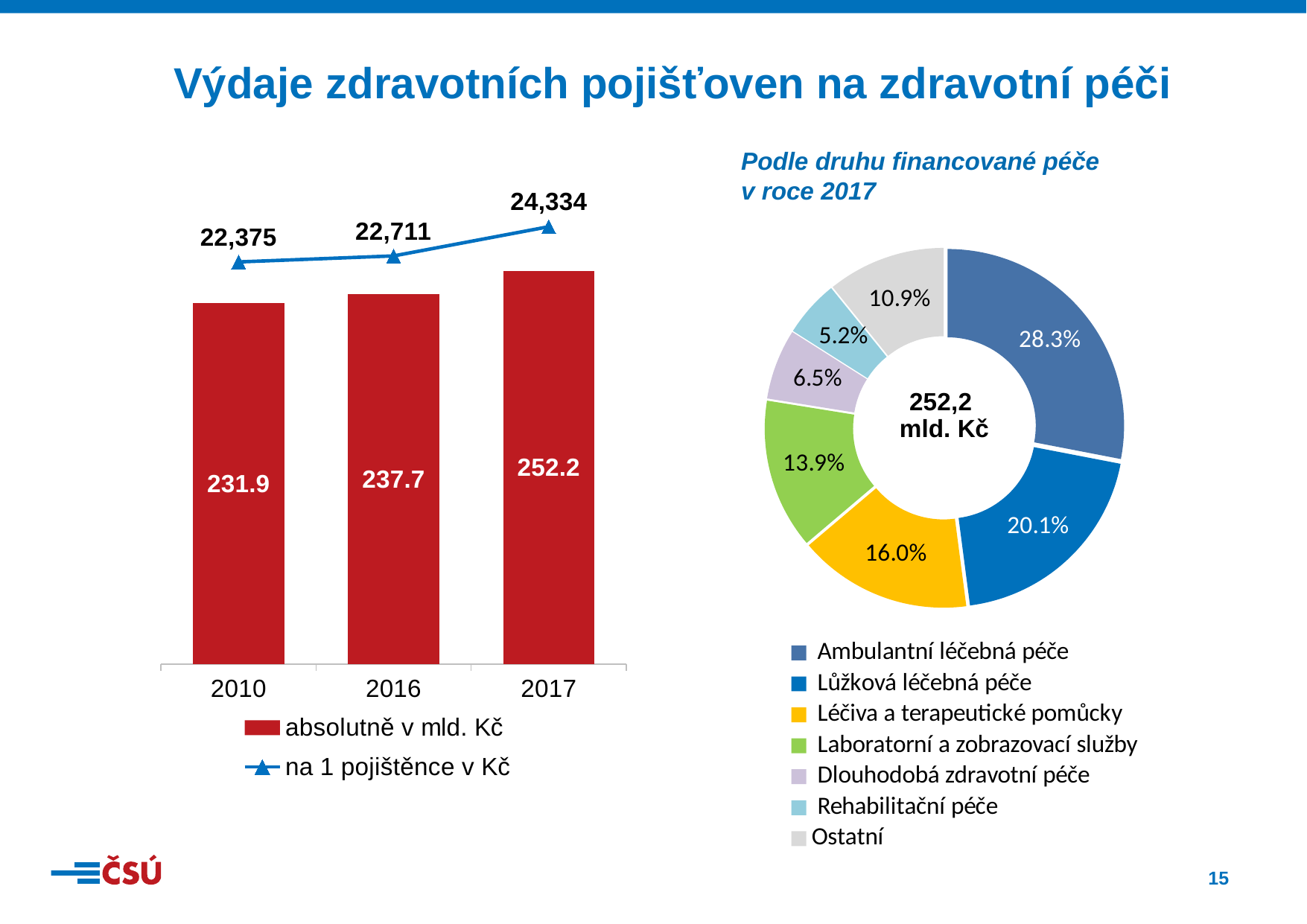
In the right chart 'Podle druhu financované péče v roce 2017', what share does 'Lůžková léčebná péče' have? 20.1% In the right chart 'Podle druhu financované péče v roce 2017', which category has the largest share? Ambulantní léčebná péče In the left chart, what is the value of 'na 1 pojištěnce v Kč' for 2016? 22,711 How many categories does the legend of the right chart 'Podle druhu financované péče v roce 2017' list? 7 In the right chart 'Podle druhu financované péče v roce 2017', which category has the smallest share? Rehabilitační péče In the left chart, what is the value of 'na 1 pojištěnce v Kč' for 2010? 22,375 In the left chart, what is the difference in 'na 1 pojištěnce v Kč' between 2017 and 2010? 1,959 In the left chart, do the values of 'na 1 pojištěnce v Kč' rise or fall from 2010 to 2017? rise In the left chart, which year has the lowest value of 'absolutně v mld. Kč'? 2010 In the left chart, what is the difference in 'absolutně v mld. Kč' between 2017 and 2010? 20.3 In the left chart, what is the value of 'absolutně v mld. Kč' for 2017? 252.2 How many series does the legend of the left chart list? 2